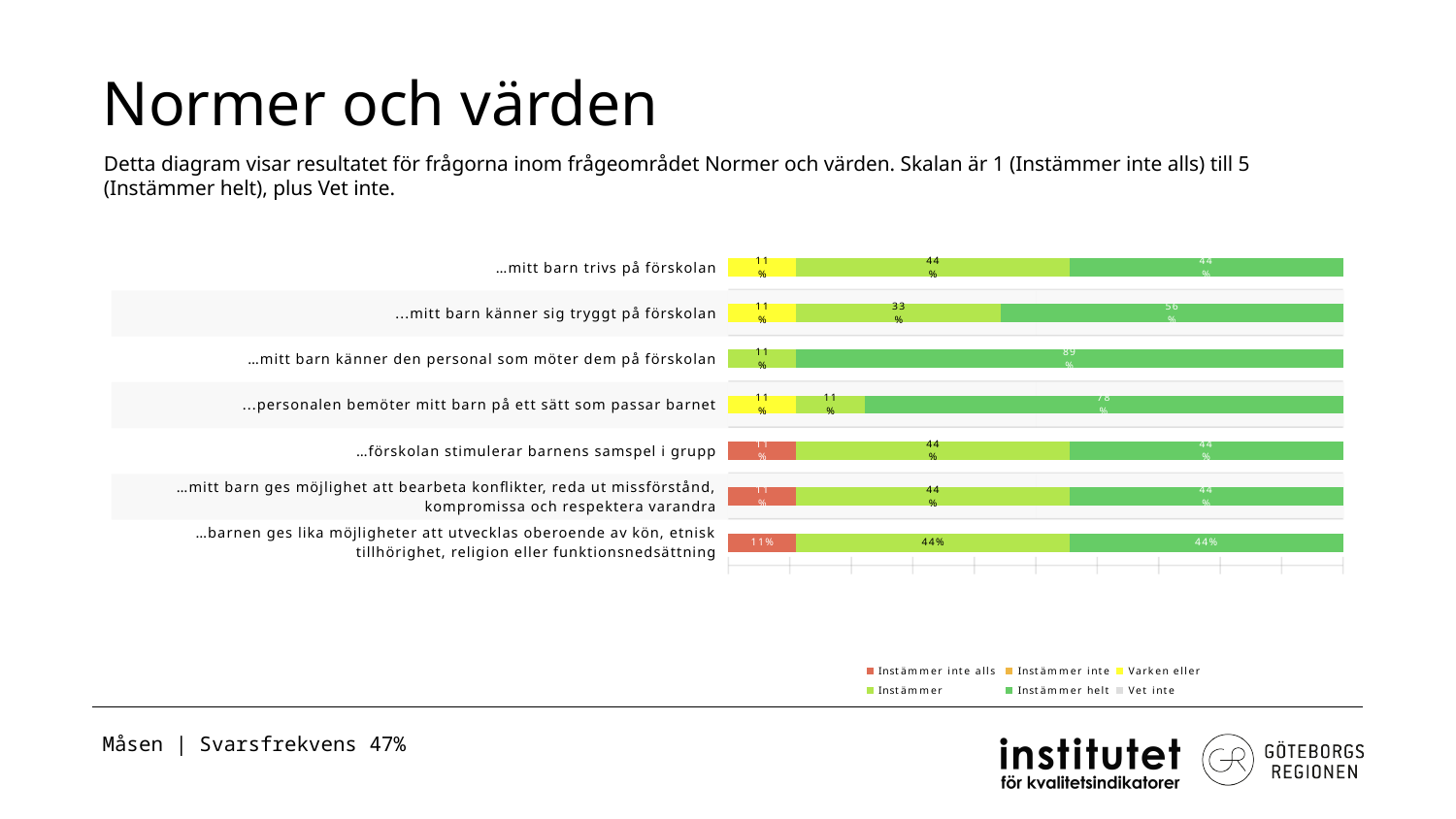
What is the 'Instämmer helt' value for '…mitt barn känner sig tryggt på förskolan'? 56% What is the 'Instämmer' value for '…personalen bemöter mitt barn på ett sätt som passar barnet'? 11% How many statements (categories) are plotted in the chart? 7 What is the difference between the 'Instämmer helt' values for '…mitt barn känner den personal som möter dem på förskolan' and '…personalen bemöter mitt barn på ett sätt som passar barnet'? 11 percentage points Which statement has the highest 'Instämmer helt' share? …mitt barn känner den personal som möter dem på förskolan What is the 'Instämmer helt' value for '…mitt barn känner den personal som möter dem på förskolan'? 89% What is the title of the slide containing the chart? Normer och värden Which is larger: the 'Instämmer helt' value for '…mitt barn känner sig tryggt på förskolan' or for '…mitt barn trivs på förskolan'? …mitt barn känner sig tryggt på förskolan What kind of chart is shown on the slide? stacked bar chart How many series does the chart legend list? 6 What is the 'Instämmer' value for '…mitt barn trivs på förskolan'? 44% What is the 'Instämmer inte alls' value for '…förskolan stimulerar barnens samspel i grupp'? 11%